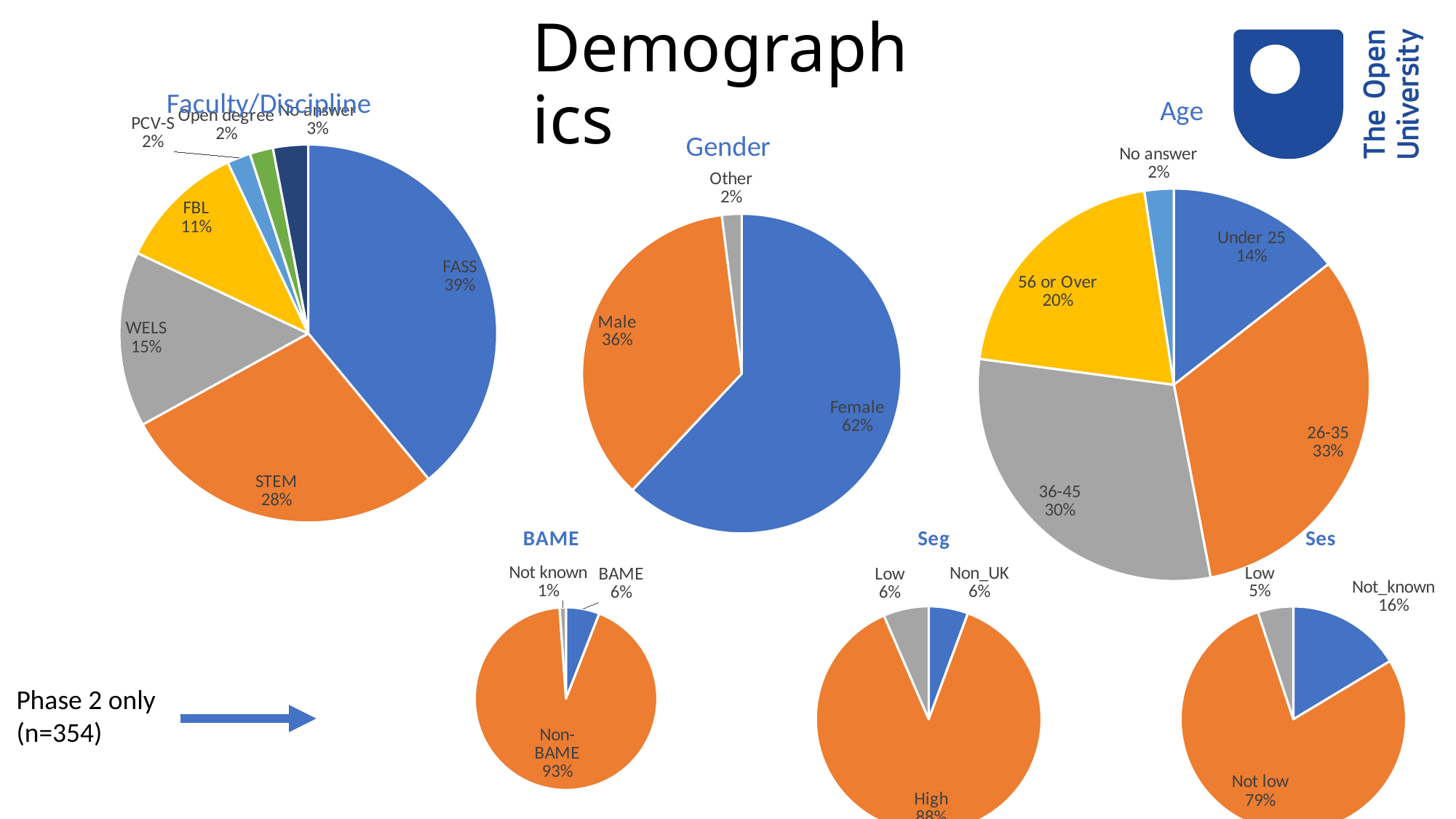
In the Ses pie chart, what share is Not_known? 16% In the Age pie chart, what share is 36-45? 30% In the Age pie chart, which age group has the largest share? 26-35 In the Gender pie chart, what share is Female? 62% In the Faculty/Discipline pie chart, which faculty has the largest share? FASS What type of chart is used for the Gender data? Pie chart In the Seg pie chart, what share is Non_UK? 6% In the BAME pie chart, what share is Non-BAME? 93% In the Faculty/Discipline pie chart, what is the difference in percentage points between STEM and WELS? 13 percentage points In the Gender pie chart, which is larger, Male or Other? Male How many slices are labelled in the Age pie chart? 5 In the Faculty/Discipline pie chart, what share is FASS? 39%